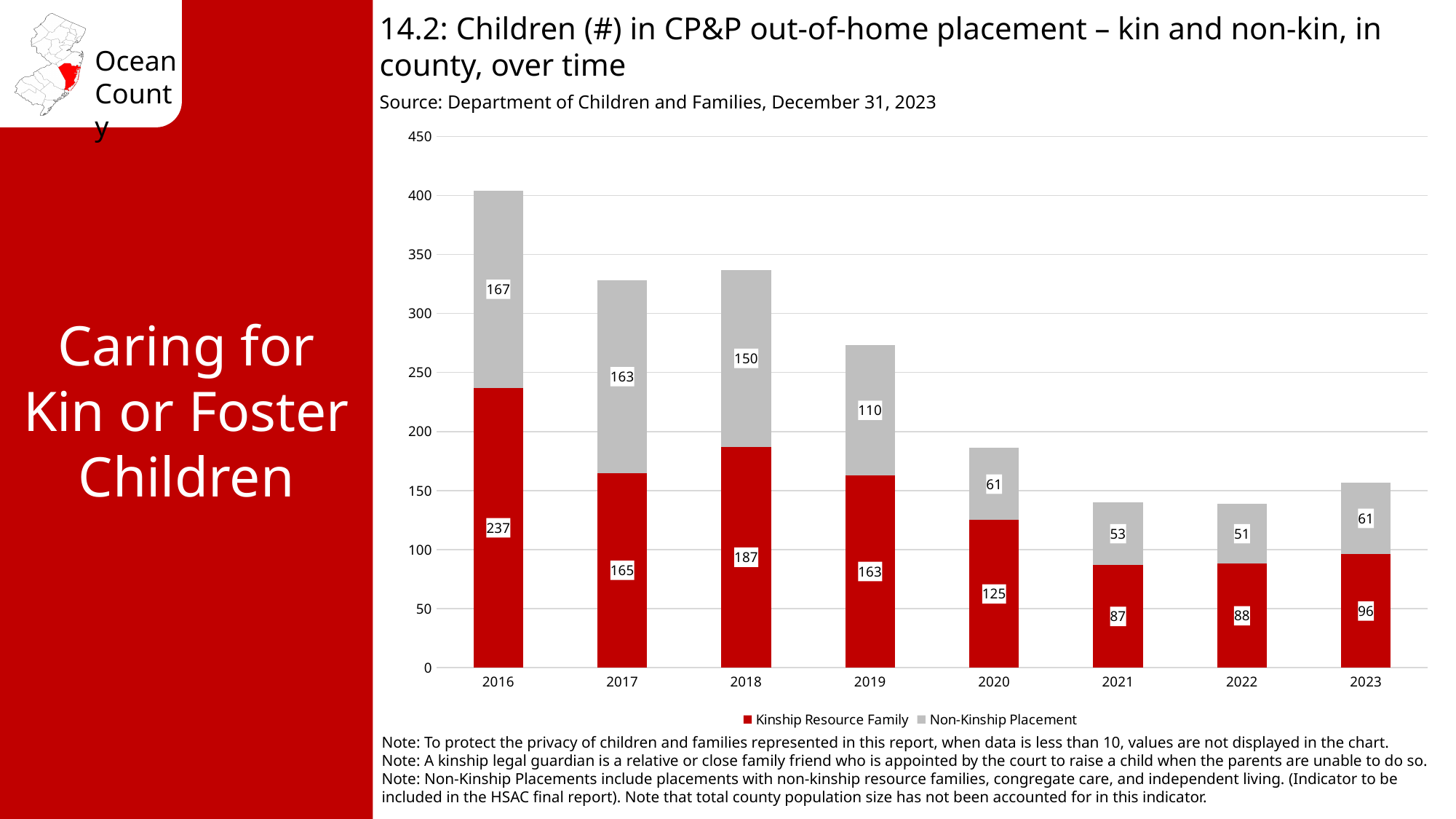
What is the total of the stacked bar for 2016? 404 How many years are shown on the x axis? 8 What is the difference between the Kinship Resource Family values for 2018 and 2019? 24 How many series does the legend list? 2 Which year has the highest Kinship Resource Family value? 2016 What is the Non-Kinship Placement value for 2019? 110 What is the Kinship Resource Family value for 2016? 237 What kind of chart is shown on the slide? Stacked bar chart Which is larger, the Non-Kinship Placement value for 2017 or for 2018? 2017 What is the total of the stacked bar for 2021? 140 What is the Kinship Resource Family value for 2023? 96 Which year has the lowest Non-Kinship Placement value? 2022